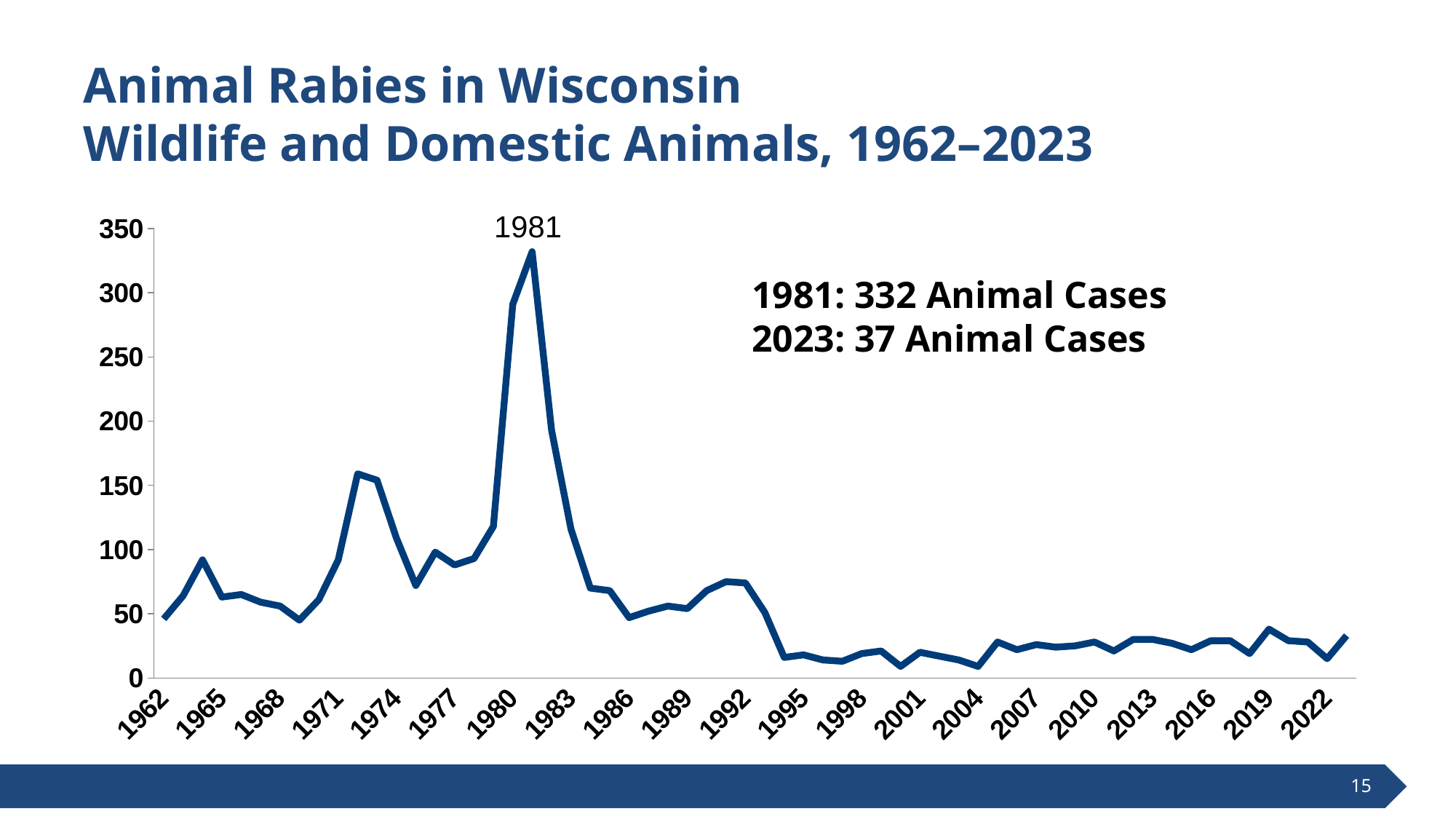
What is the highest tick value shown on the y axis? 350 Is the value for 1972 greater or less than 100? greater How many animal rabies cases were there in 2023? 37 Is the value for 1962 greater or less than 100? less Which year had more animal cases, 1981 or 2023? 1981 Is the value for 2004 greater or less than 50? less What is the difference between the number of animal cases in 1981 and in 2023? 295 In which year does the line reach its highest value? 1981 Do the values rise or fall between 1981 and 1985? fall Which year had a higher value, 1972 or 1992? 1972 How many animal rabies cases were there in 1981? 332 What kind of chart is shown on the slide? line chart